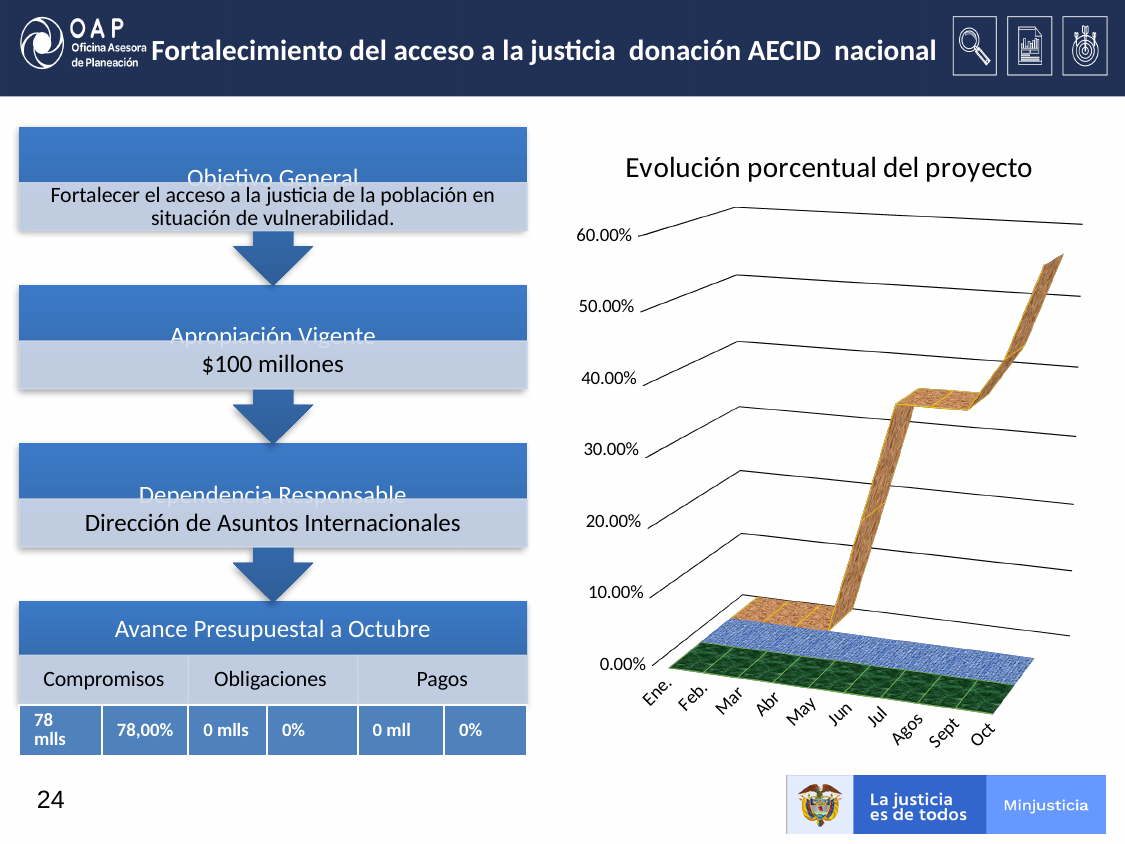
Is the value for Oct greater or less than 40.00%? greater Is the value for Mar greater or less than 10.00%? less Is the value for Jul greater or less than 20.00%? greater Do the values in the chart generally rise or fall from Ene. to Oct? rise What is the highest tick label shown on the vertical axis of the chart? 60.00% Which is larger, the value for Oct or the value for Jul? Oct What kind of chart is shown on the slide? line chart Which is larger, the value for Agos or the value for Feb.? Agos How many months are shown on the x axis of the chart? 10 What is the title of the chart on the slide? Evolución porcentual del proyecto Which month has the highest value in the chart? Oct